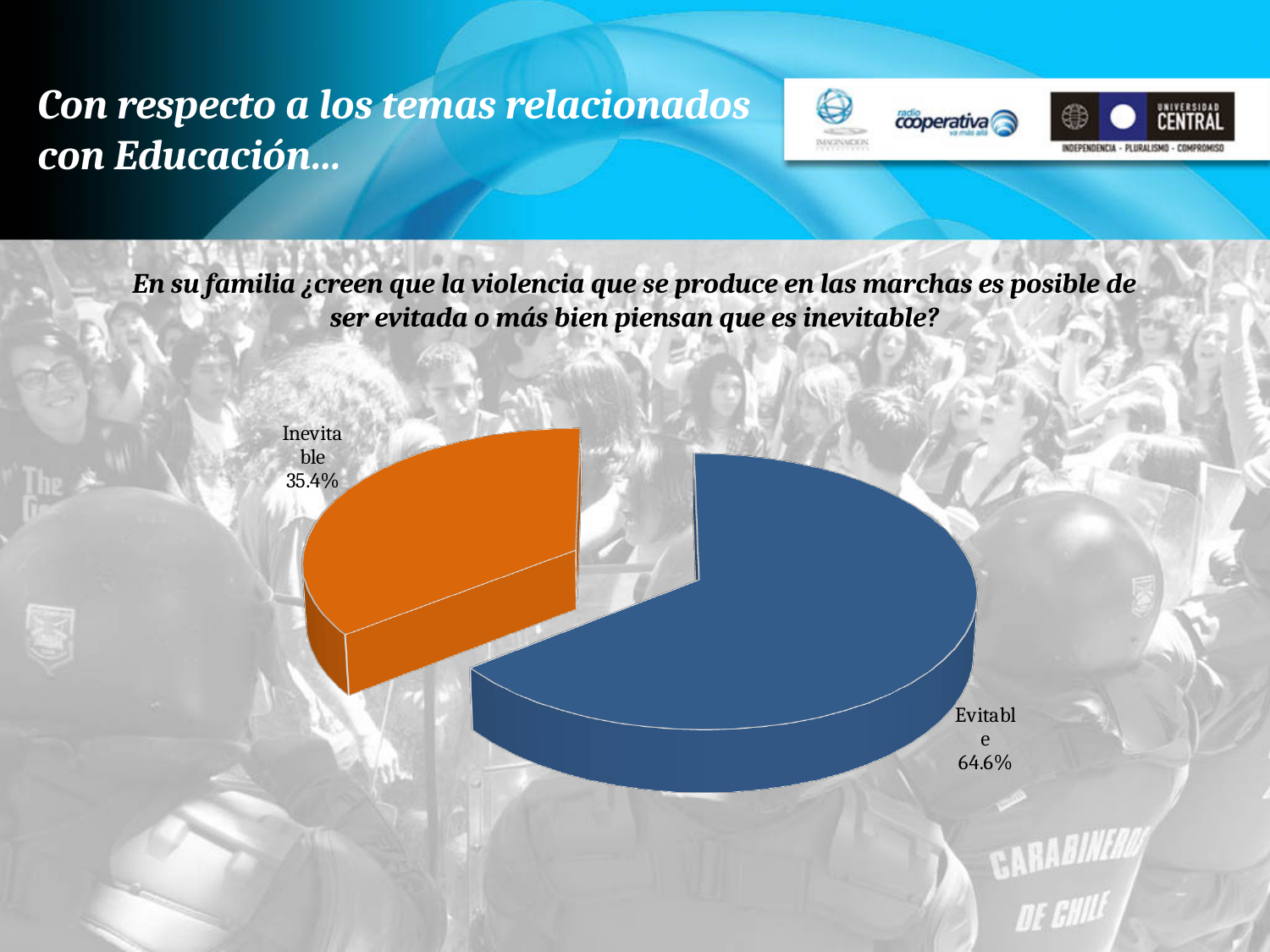
How many slices does the pie chart have? 2 What is the difference in percentage points between "Evitable" and "Inevitable"? 29.2 Which response has the largest share of the pie? Evitable Which response has the smallest share of the pie? Inevitable What share of the pie does the "Inevitable" slice represent? 35.4% What colour is the "Evitable" slice? Blue What kind of chart is shown on the slide? Pie chart Which is larger, the share for "Evitable" or the share for "Inevitable"? Evitable What percentage of respondents answered "Inevitable"? 35.4% What colour is the "Inevitable" slice? Orange What percentage of respondents answered "Evitable"? 64.6%